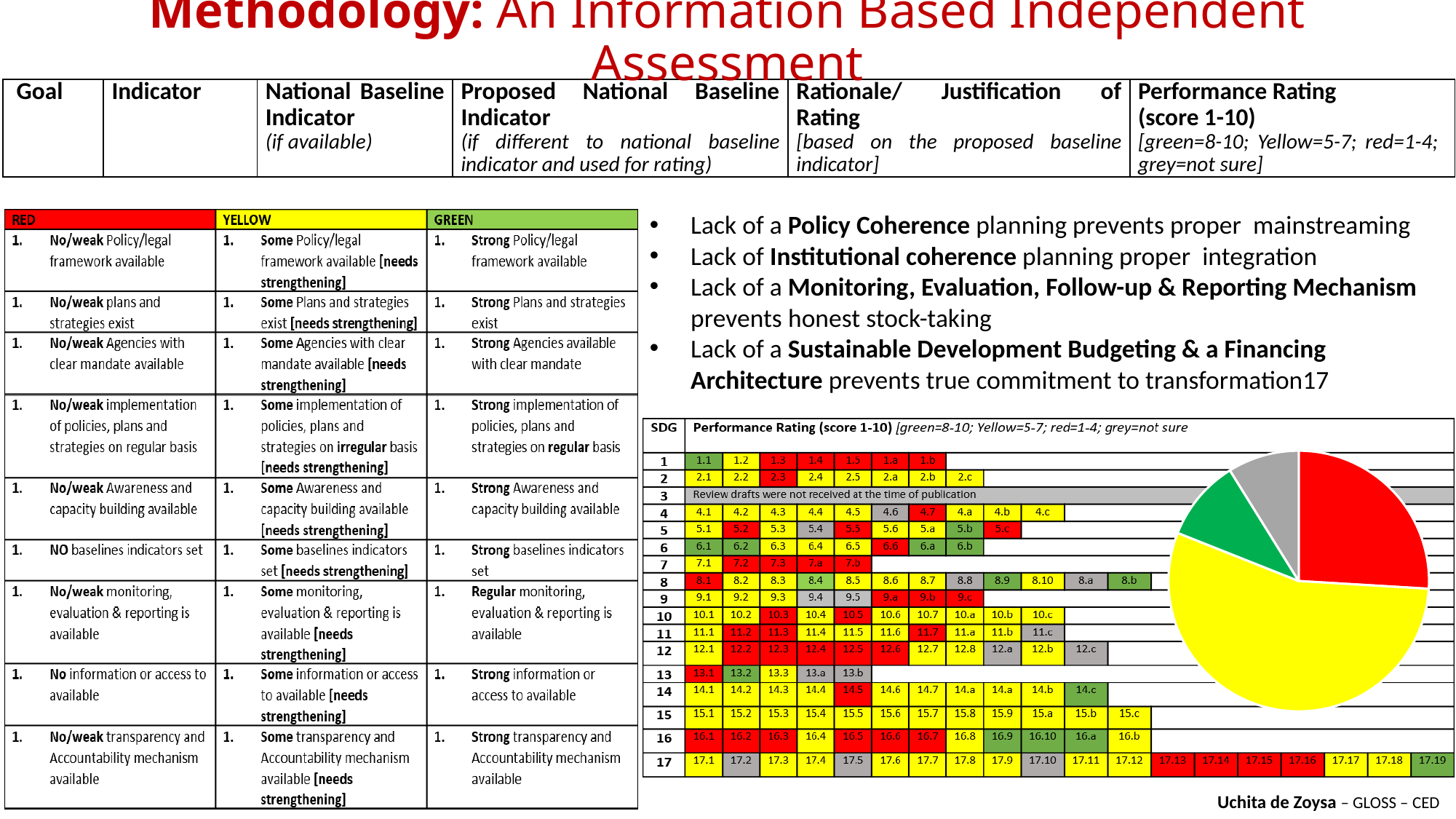
Which colour slice is the largest in the pie chart? yellow Does the pie chart show a legend or data labels? No What colours are the slices of the pie chart? yellow, red, green, grey In the pie chart, which slice is larger, the yellow one or the red one? yellow Does the yellow slice of the pie chart cover more or less than half of the pie? more In the pie chart, which slice is larger, the red one or the grey one? red In the pie chart, which slice is larger, the red one or the green one? red What kind of chart is shown on the right side of the slide? pie chart How many slices does the pie chart have? 4